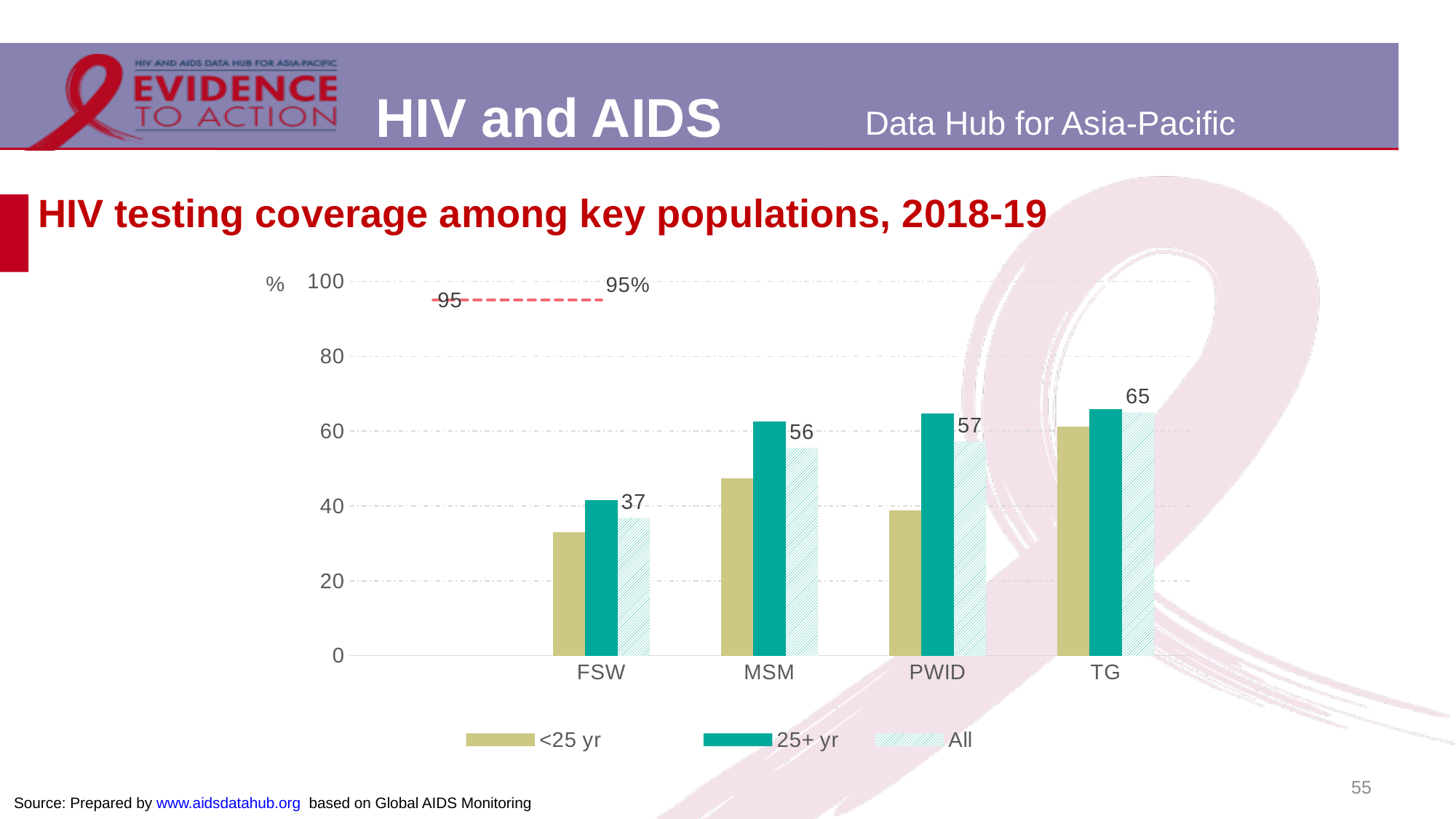
What is the HIV testing coverage for the All series among TG? 65 Is the value for <25 yr among MSM greater or less than 60? less What is the HIV testing coverage for the All series among FSW? 37 Which is larger, the All value for PWID or the All value for FSW? PWID What is the HIV testing coverage for the All series among MSM? 56 Which key population has the highest value for the All series? TG Is the value for 25+ yr among PWID greater or less than 60? greater What target value is marked by the dashed line on the chart? 95% How many key populations are shown on the x axis? 4 Which key population has the lowest value for the All series? FSW What is the difference between the All values for TG and FSW? 28 How many series does the legend list? 3